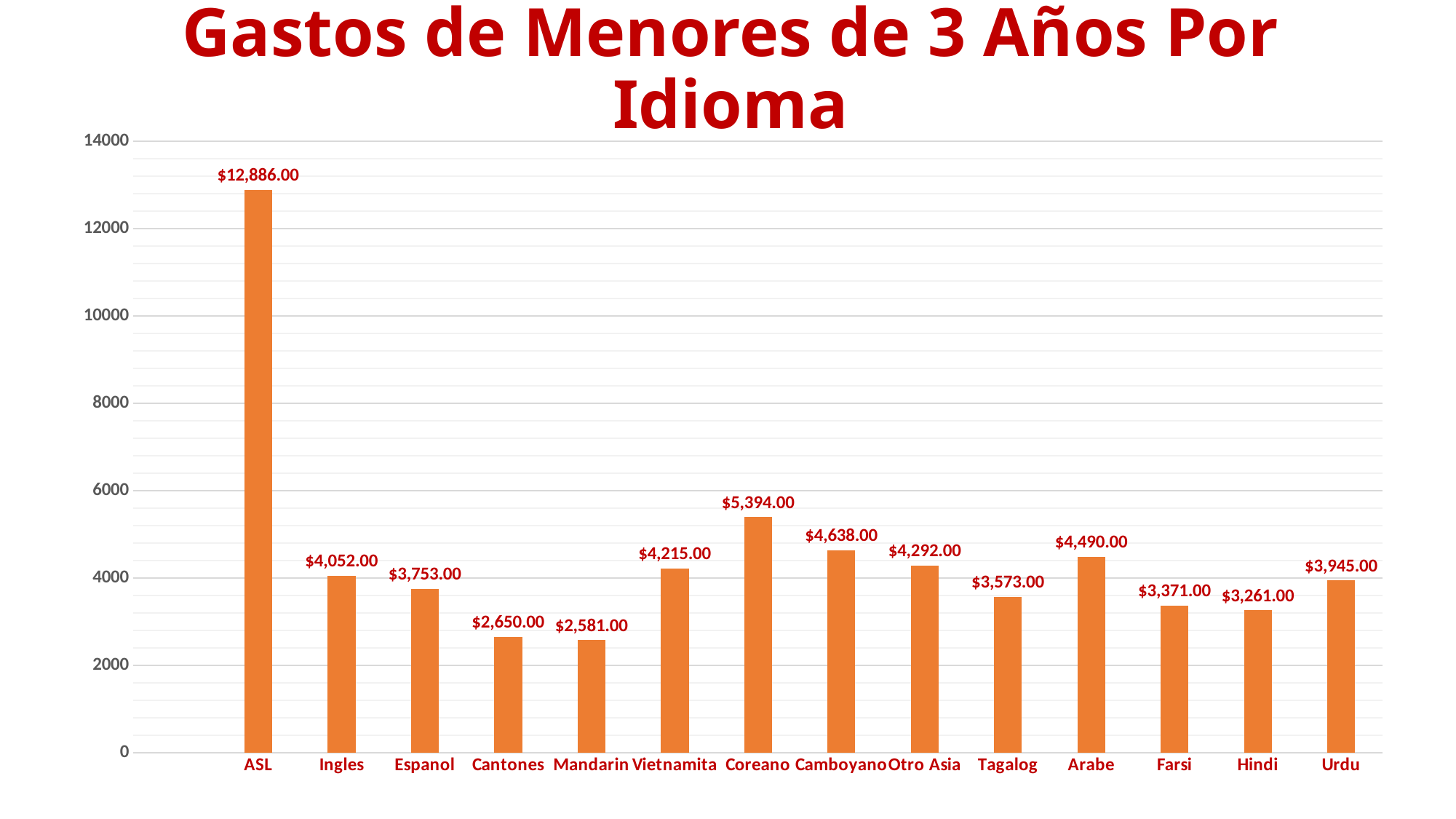
Which is larger, the value for Arabe or the value for Tagalog? Arabe Which category has the lowest value? Mandarin What kind of chart is shown on the slide? bar chart What is the title of the chart? Gastos de Menores de 3 Años Por Idioma Is the value for Ingles greater or less than 4000? greater Which category has the highest value? ASL How many categories are shown on the x axis? 14 What is the value for Coreano? $5,394.00 What is the difference between the values for Cantones and Mandarin? $69.00 What is the value for ASL? $12,886.00 What is the difference between the values for Coreano and Camboyano? $756.00 What is the value for Urdu? $3,945.00